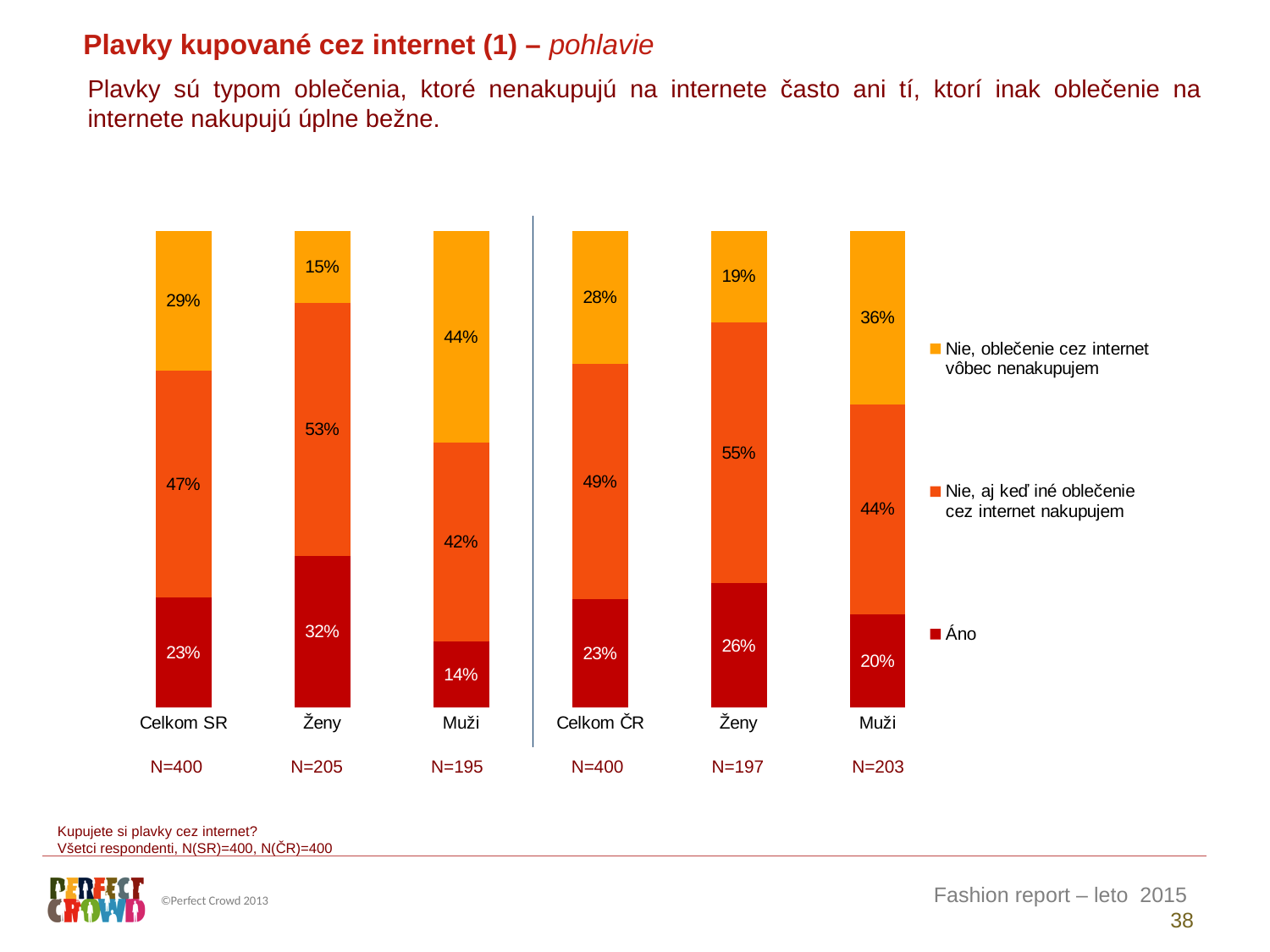
Which is larger: the "Áno" value for Celkom SR or the "Áno" value for Ženy in the ČR group? Ženy (ČR) What is the difference between the "Nie, oblečenie cez internet vôbec nenakupujem" values for Muži in the SR group and Ženy in the SR group? 29% Which category has the lowest "Áno" value? Muži (SR) What is the "Nie, oblečenie cez internet vôbec nenakupujem" value for Muži in the ČR group (right side)? 36% What is the "Áno" value for Celkom SR? 23% What is the total of the stacked bar for Celkom ČR? 100% What is the "Nie, aj keď iné oblečenie cez internet nakupujem" value for Ženy in the ČR group (right side)? 55% What kind of chart is shown on the slide? stacked bar chart What is the sample size (N) shown under Muži in the SR group? N=195 How many series does the legend list? 3 Which category has the highest "Áno" value? Ženy (SR) How many bars (categories) are plotted in the chart? 6